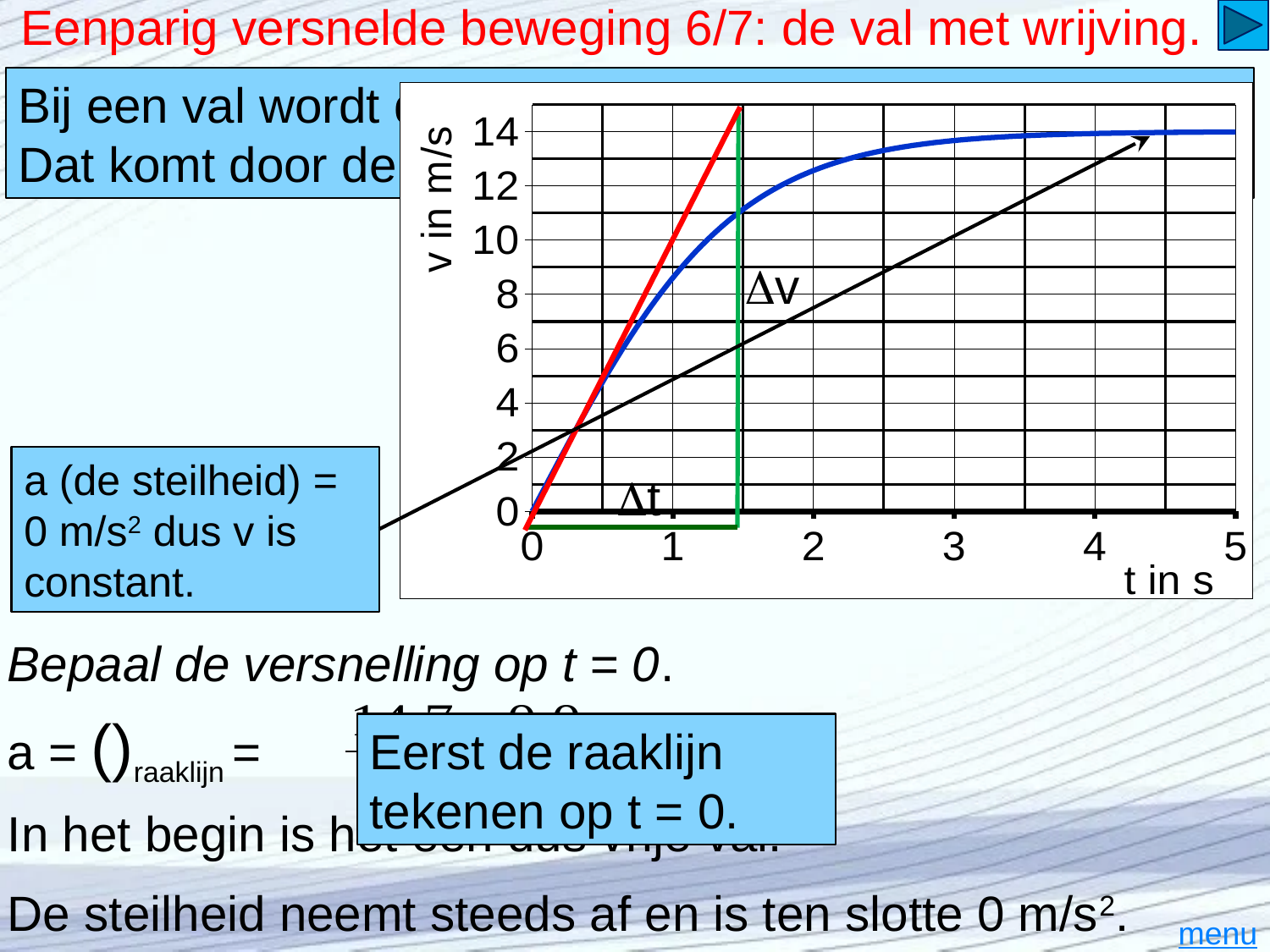
What is the label of the horizontal axis of the chart? t in s Is the value of the red tangent line at t = 1 s greater or less than 8? greater At which time does the blue curve have its lowest value, t = 0 s or t = 5 s? t = 0 s What kind of chart is shown on the slide? line chart What is the label of the vertical axis of the chart? v in m/s What is the highest tick value shown on the vertical axis? 14 Is the value of the blue curve at t = 1 s greater or less than 6? greater Does the blue curve rise or fall as t increases? rise Is the value of the blue curve at t = 4 s greater or less than 10? greater